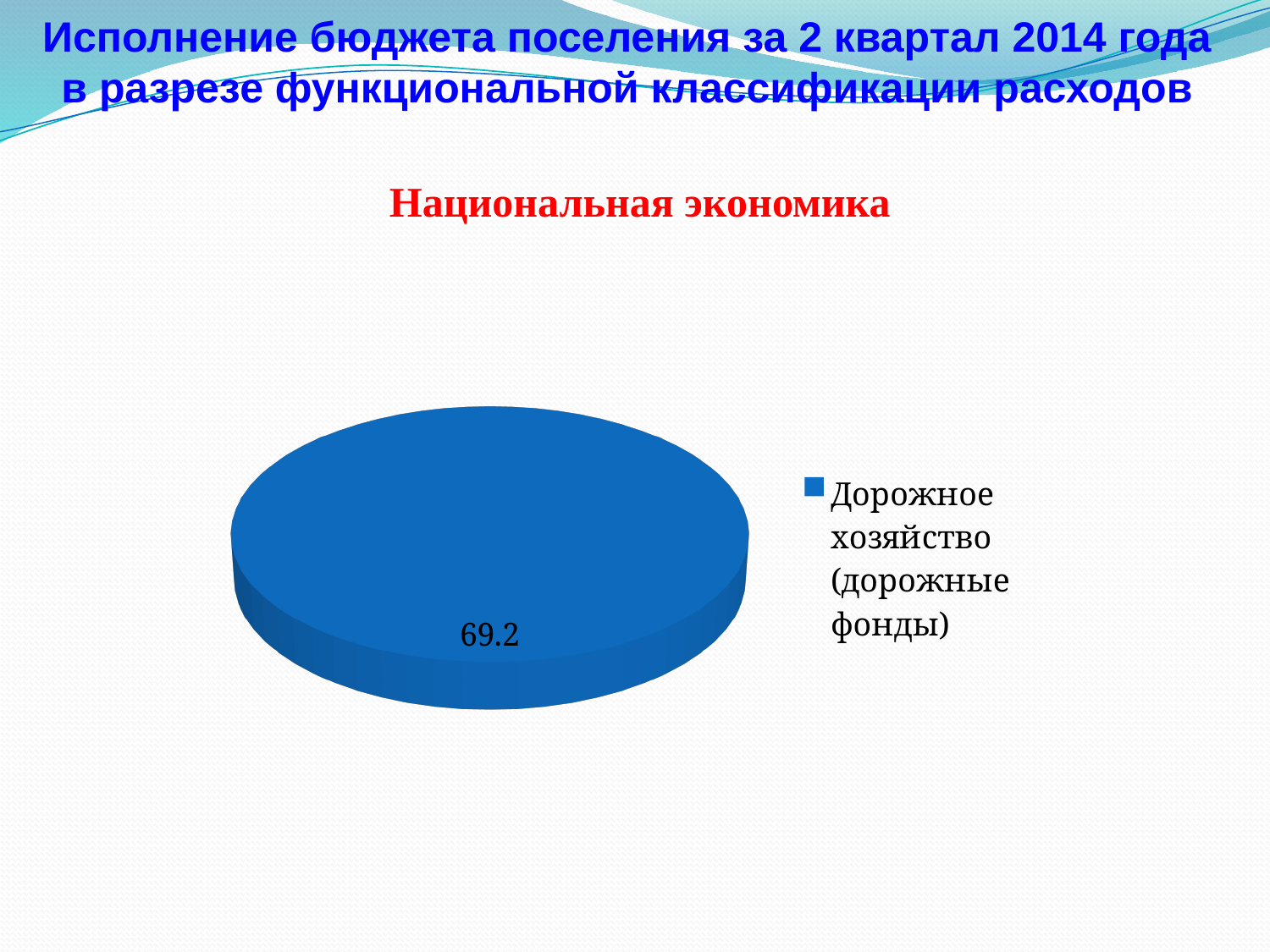
What kind of chart is shown on the slide? pie chart What category does the legend entry name? Дорожное хозяйство (дорожные фонды) What is the value shown for Дорожное хозяйство (дорожные фонды)? 69.2 What share of the pie does Дорожное хозяйство (дорожные фонды) take? 100% How many slices does the pie chart have? 1 How many entries does the legend list? 1 What is the title of the chart? Национальная экономика